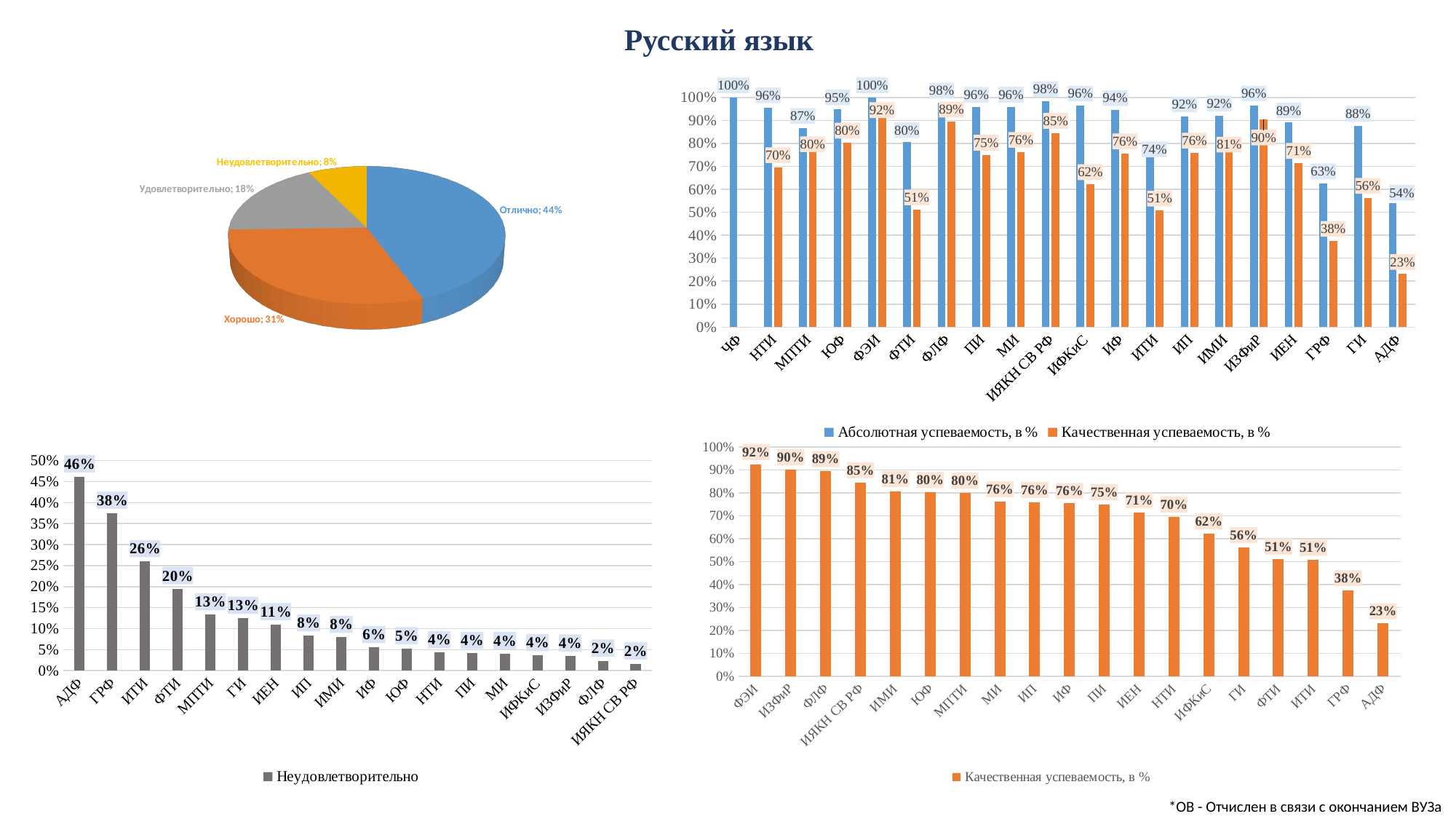
In the pie chart at the top left, which category has the smallest slice? Неудовлетворительно In the top-right bar chart, what is the Качественная успеваемость value for ФТИ? 51% In the bottom-left bar chart (Неудовлетворительно), do the values rise or fall from left to right along the x axis? fall In the top-right bar chart, what is the difference between the Абсолютная успеваемость and Качественная успеваемость values for АДФ? 31% In the top-right bar chart, how many series does the legend list? 2 In the bottom-right bar chart (Качественная успеваемость), which category has the lowest value? АДФ In the pie chart at the top left, what share does the Отлично slice have? 44% In the bottom-left bar chart (Неудовлетворительно), what is the value for ИТИ? 26% In the top-right bar chart, what is the Абсолютная успеваемость value for ГРФ? 63% What kind of chart is shown at the bottom right of the slide? bar chart In the bottom-right bar chart (Качественная успеваемость), which is larger, the value for ИЕН or the value for ГИ? ИЕН In the bottom-left bar chart (Неудовлетворительно), which category has the highest value? АДФ